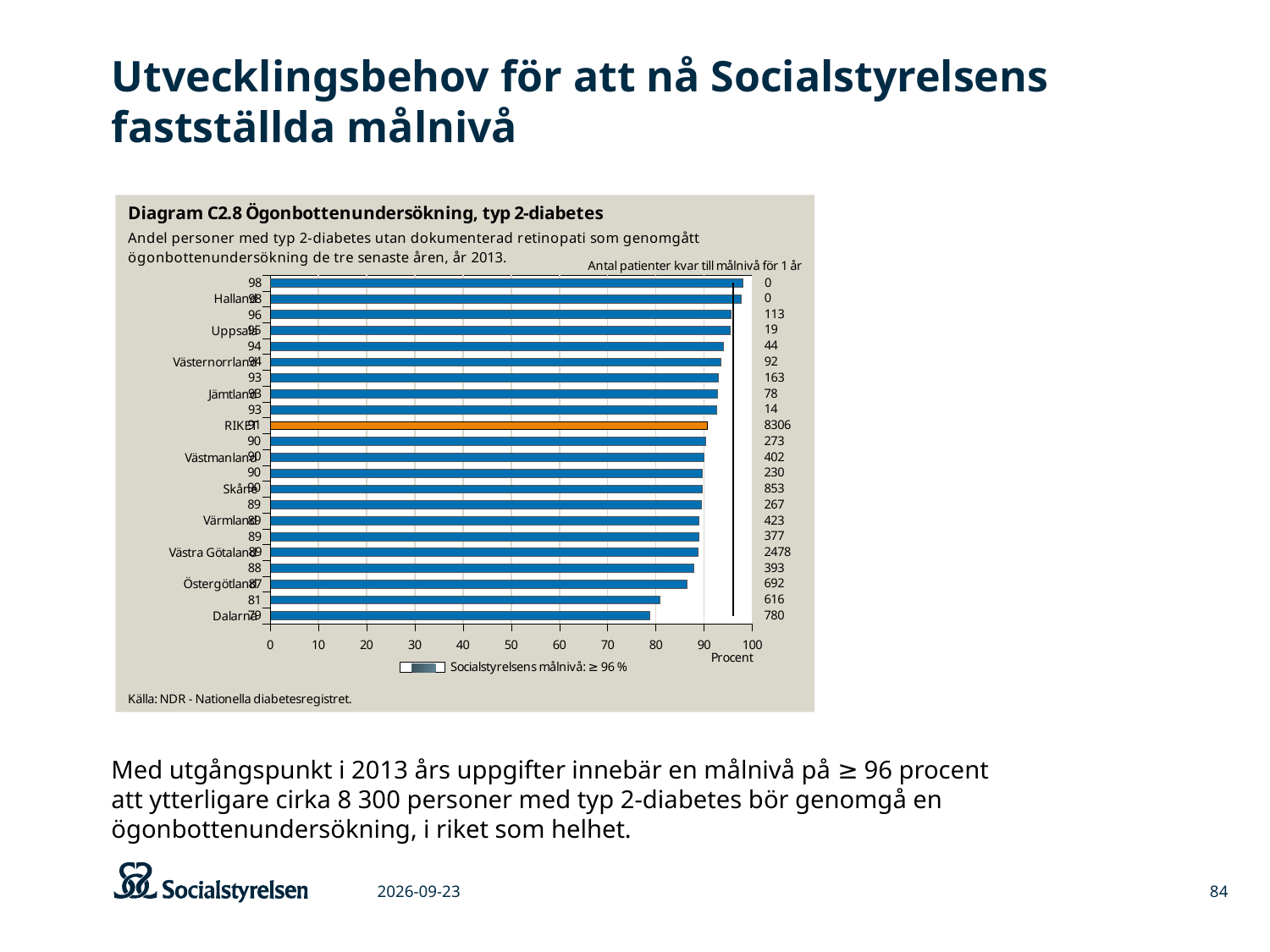
What is the value for Uppsala in the chart? 95 What is the value for RIKET in the chart? 91 What is the difference between the values for Halland and Dalarna? 19 What is the value for Halland in the chart? 98 Which has a higher value, Jämtland or Skåne? Jämtland Which category has the lowest value in the chart? Dalarna What is the value for Dalarna in the chart? 79 According to the right-hand column, how many patients remain to reach the target level for RIKET? 8306 How many bars are plotted in the chart? 22 What target level (Socialstyrelsens målnivå) is stated in the chart legend? ≥ 96 % According to the right-hand column, how many patients remain to reach the target level for Västra Götaland? 2478 What kind of chart is shown on the slide? bar chart